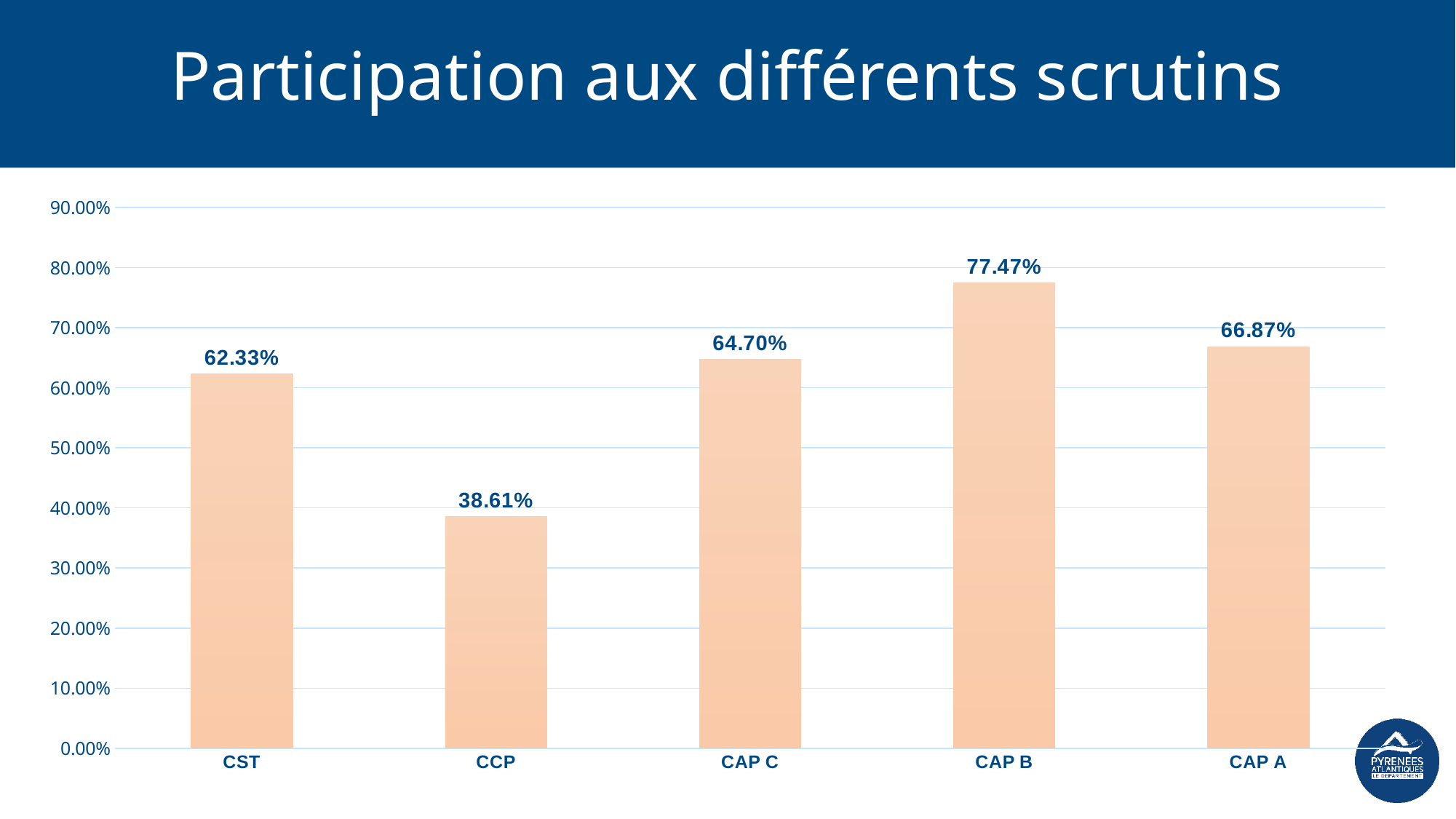
Which category has the lowest participation? CCP How many categories are shown on the chart? 5 What is the participation value for CST? 62.33% What is the participation value for CAP B? 77.47% Is the value for CCP greater or less than 40.00%? less What is the participation value for CAP A? 66.87% What is the participation value for CCP? 38.61% Which has a higher participation, CAP C or CAP A? CAP A What kind of chart is shown on the slide? bar chart What is the difference between the participation for CAP B and CCP? 38.86% What is the title of the slide? Participation aux différents scrutins Which category has the highest participation? CAP B